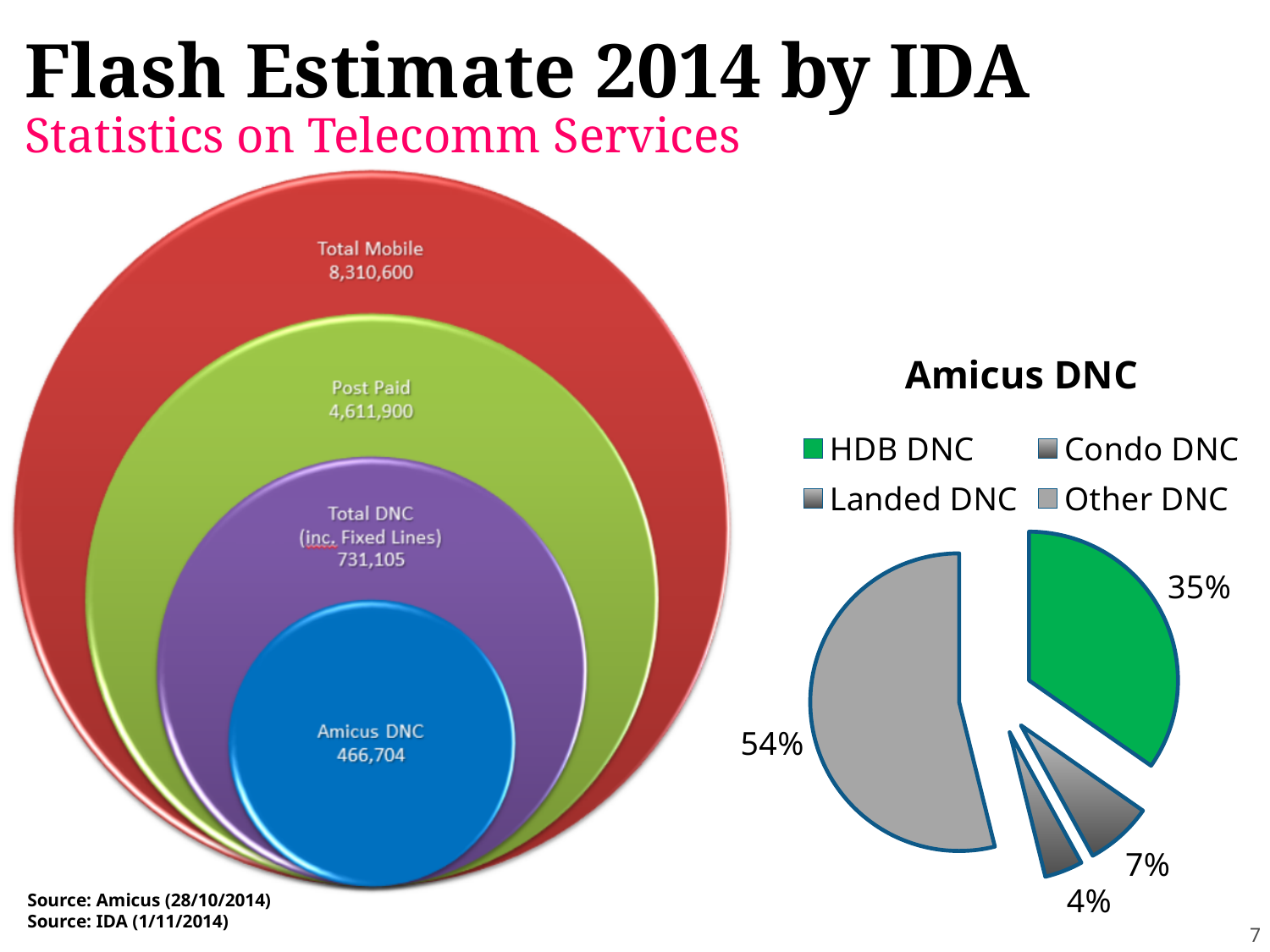
In the Amicus DNC pie chart, what share does Landed DNC have? 4% In the Amicus DNC pie chart, which category has the smallest slice? Landed DNC In the nested circle chart on the left, what is the value for Post Paid? 4,611,900 What kind of chart is the Amicus DNC chart on the right of the slide? Pie chart In the nested circle chart on the left, what is the difference between Total DNC (inc. Fixed Lines) and Amicus DNC? 264,401 In the Amicus DNC pie chart, what share does Condo DNC have? 7% In the Amicus DNC pie chart, which category has the largest slice? Other DNC In the nested circle chart on the left, what is the value for Total Mobile? 8,310,600 In the Amicus DNC pie chart, what share does Other DNC have? 54% How many categories does the legend of the Amicus DNC pie chart list? 4 In the Amicus DNC pie chart, how many percentage points larger is Other DNC than HDB DNC? 19 percentage points